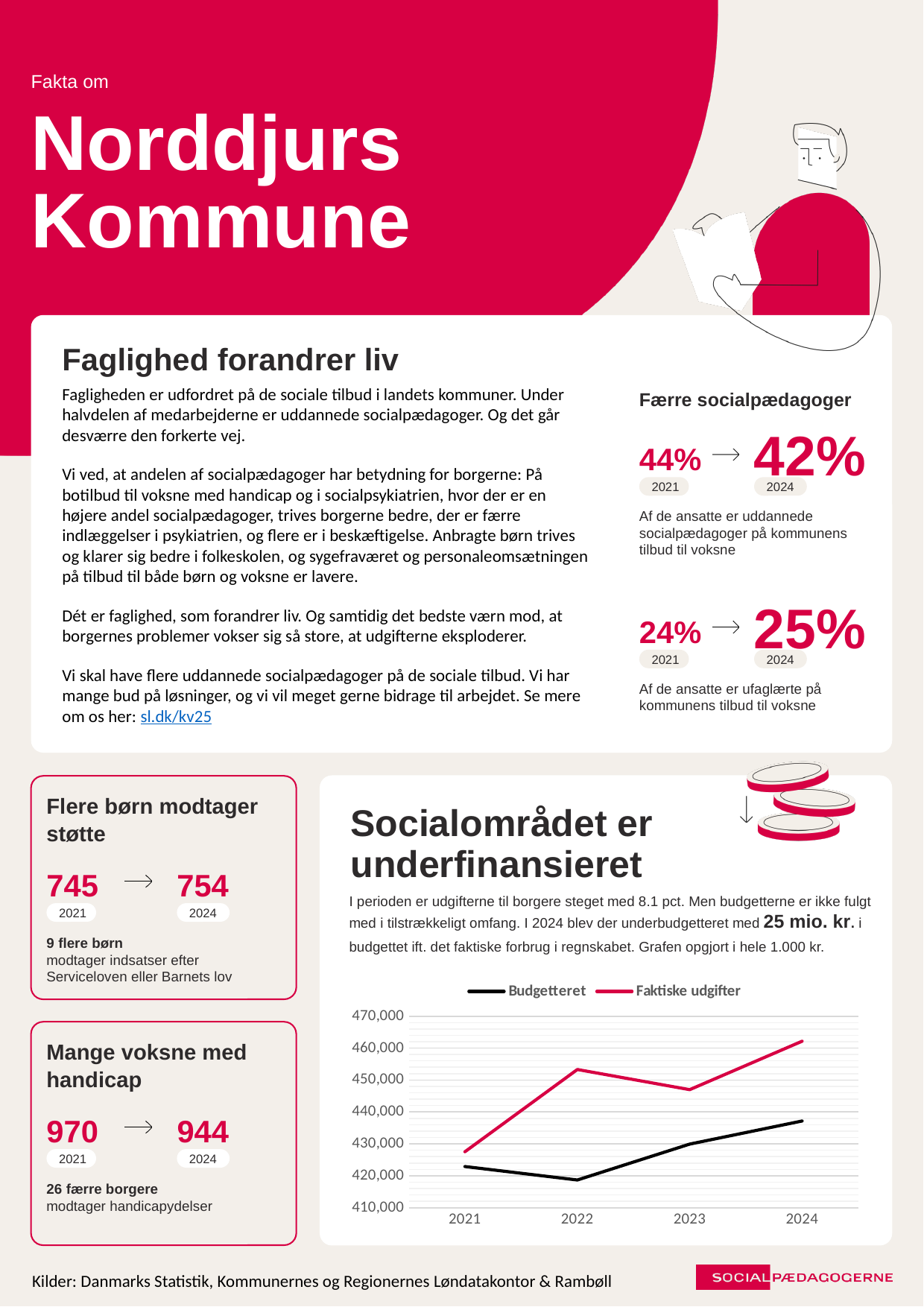
What colour is the Faktiske udgifter line in the chart? red Which two series are listed in the legend of the line chart? Budgetteret and Faktiske udgifter In the line chart, which year has the highest value for Faktiske udgifter? 2024 Is the value for Faktiske udgifter in 2024 greater or less than 450,000? greater Is the value for Faktiske udgifter in 2022 greater or less than 440,000? greater How many series does the legend of the line chart list? 2 In the line chart, which series is higher in 2023, Budgetteret or Faktiske udgifter? Faktiske udgifter What kind of chart is shown under the heading 'Socialområdet er underfinansieret'? line chart In the line chart, which year has the lowest value for Budgetteret? 2022 Is the value for Budgetteret in 2022 greater or less than 430,000? less How many years are plotted along the x axis of the line chart? 4 Does the Budgetteret line rise or fall from 2022 to 2024? rise